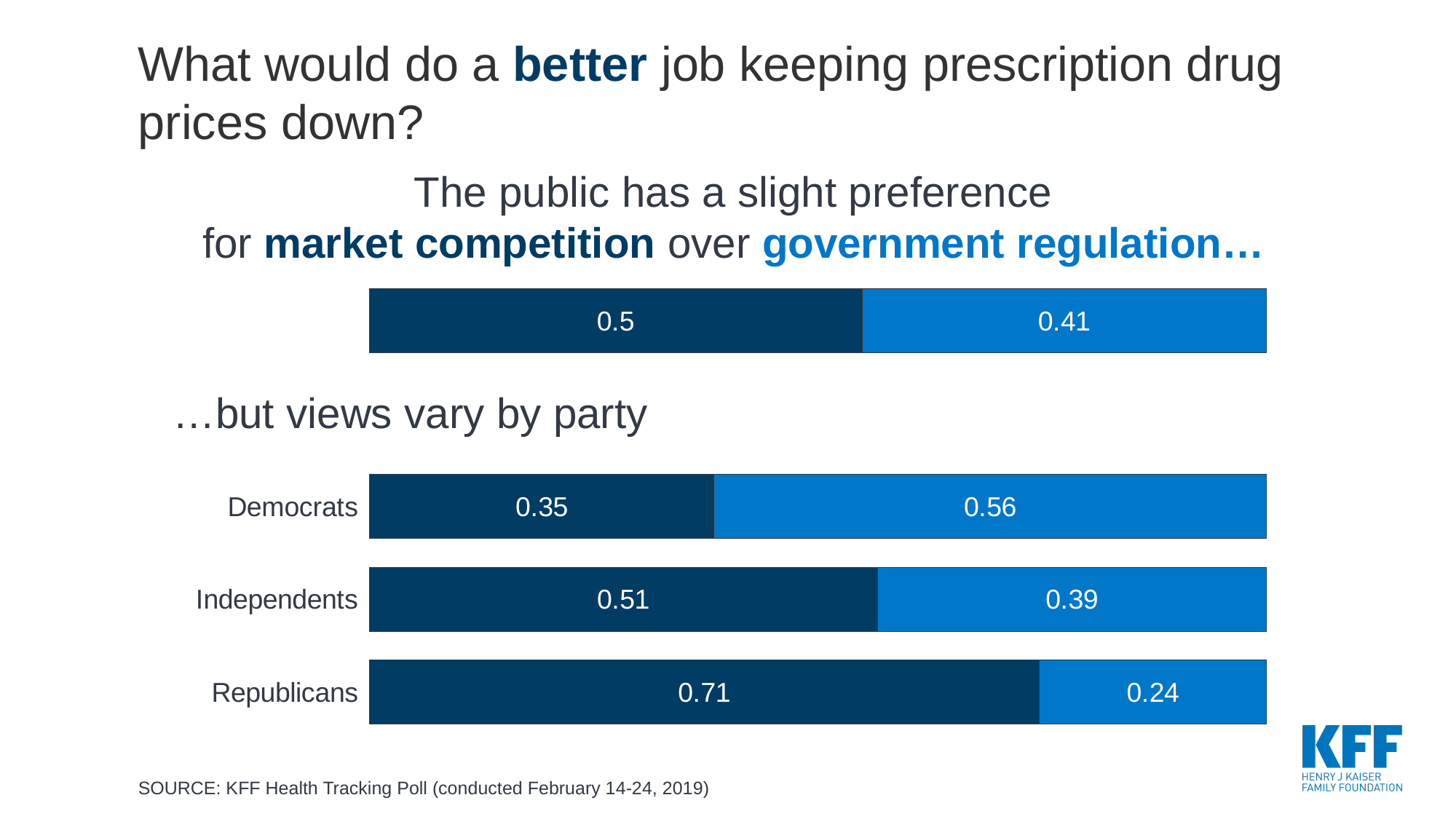
In the bottom chart (views by party), how many parties are shown? 3 What type of chart is used in the bottom chart (views by party)? stacked bar chart In the bottom chart (views by party), what is the total of the two values for Independents? 0.9 In the bottom chart (views by party), which party has the lowest government regulation value? Republicans In the bottom chart (views by party), what is the government regulation value for Independents? 0.39 In the bottom chart (views by party), what is the government regulation value for Democrats? 0.56 In the top chart (the public overall), what is the value for government regulation? 0.41 In the top chart (the public overall), what is the value for market competition? 0.5 In the bottom chart (views by party), which is larger for Independents: market competition or government regulation? market competition In the bottom chart (views by party), what is the difference between the market competition values for Republicans and Democrats? 0.36 In the bottom chart (views by party), what is the market competition value for Republicans? 0.71 In the bottom chart (views by party), which party has the highest market competition value? Republicans